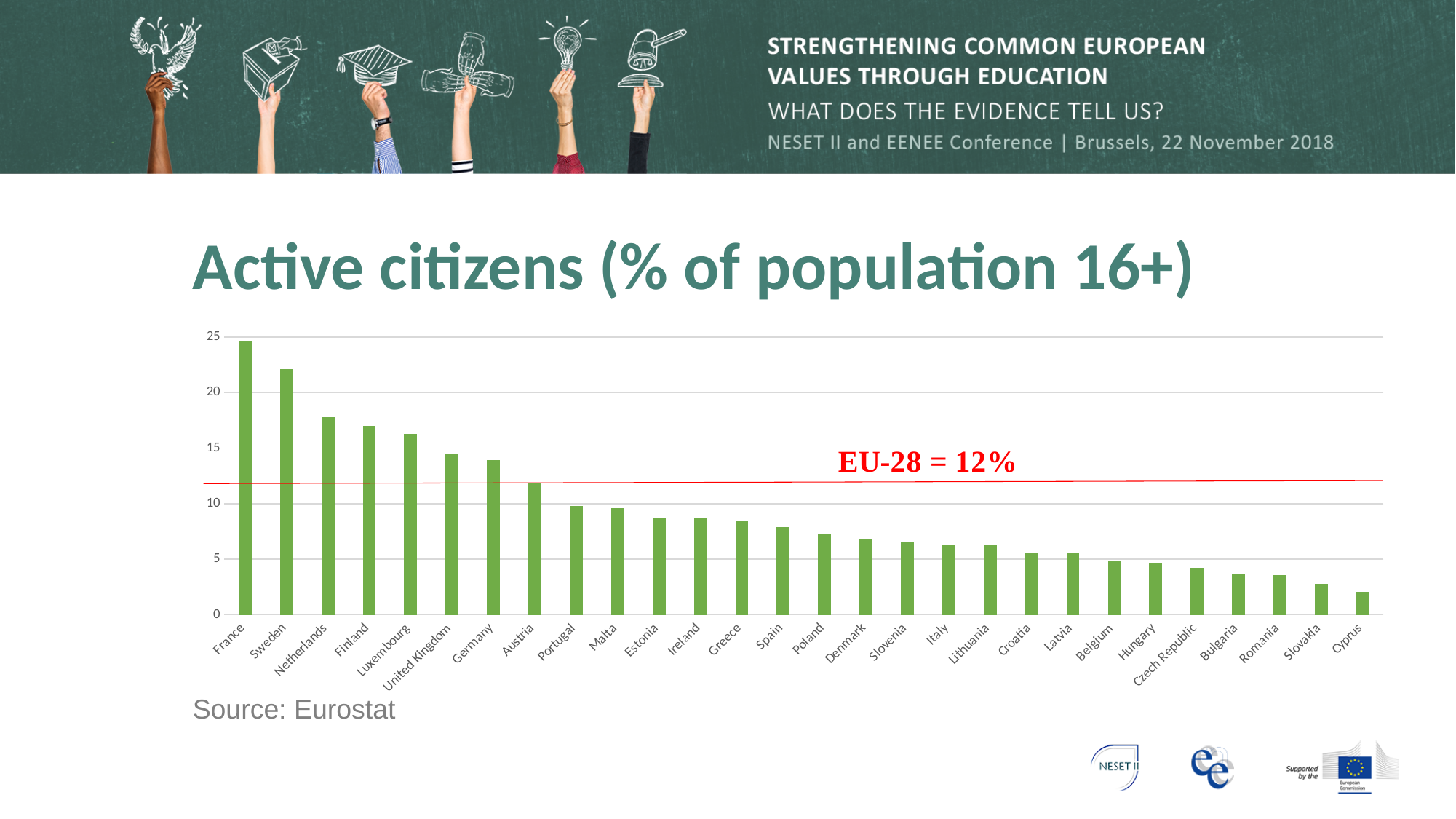
Is the value for Netherlands greater or less than 20? less Which country has the lowest share of active citizens in the chart? Cyprus Which has a larger value, France or Sweden? France Is the value for Germany greater or less than 15? less Which country has the highest share of active citizens in the chart? France Do the values rise or fall moving from left to right along the x axis? fall Is the value for Sweden greater or less than 20? greater What EU-28 value is marked by the red reference line on the chart? 12% How many countries are shown on the x axis of the chart? 28 What type of chart is shown on the slide? bar chart